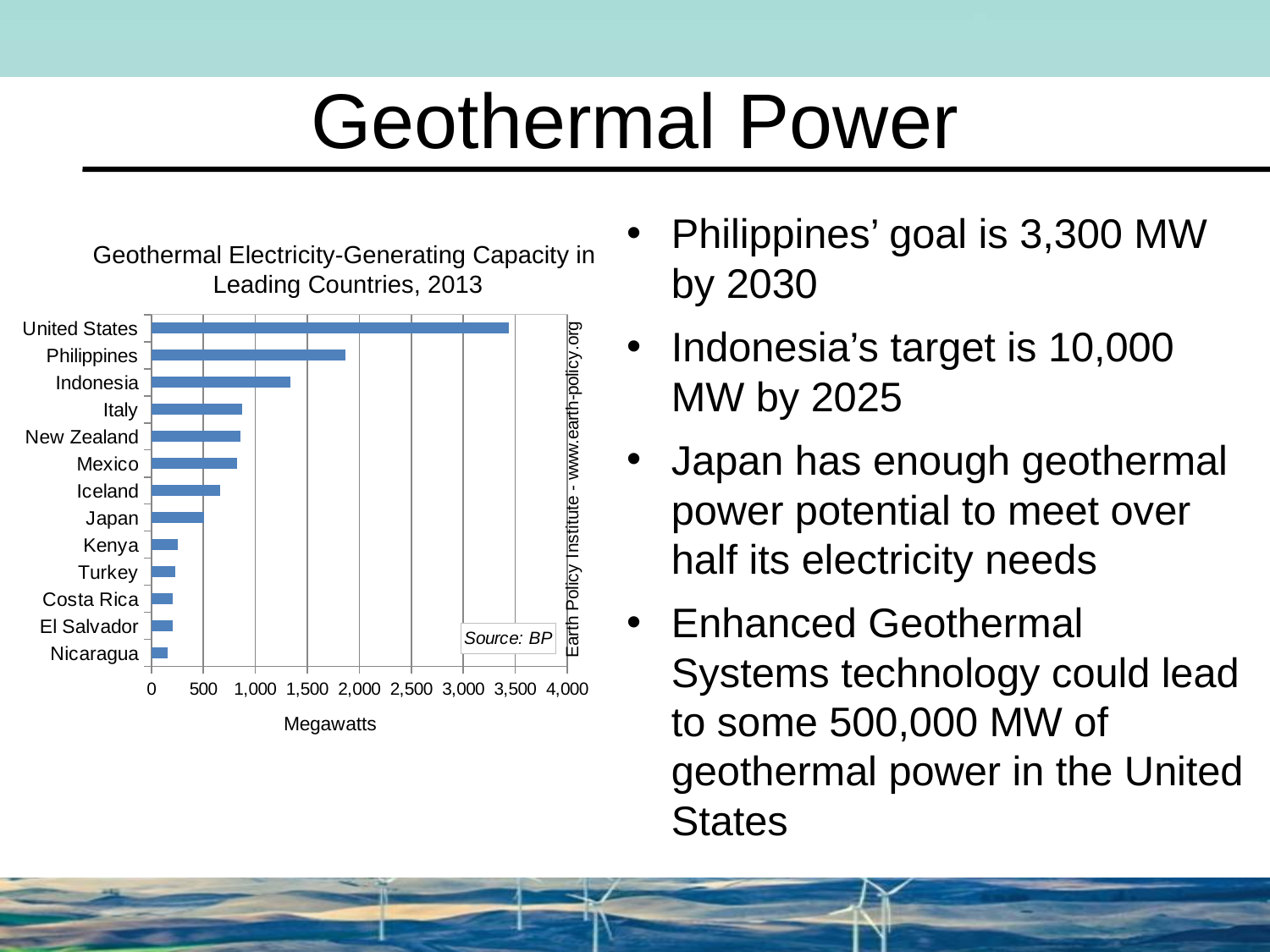
Is the value for Indonesia greater or less than 1,000? greater What is the label on the horizontal axis of the chart? Megawatts What kind of chart is shown on the slide? bar chart Is the value for Iceland greater or less than 500? greater Which country has the lowest geothermal electricity-generating capacity in the chart? Nicaragua Which has a larger geothermal capacity, Indonesia or Mexico? Indonesia Is the value for the Philippines greater or less than 1,500? greater What is the title of the chart? Geothermal Electricity-Generating Capacity in Leading Countries, 2013 Which country has the highest geothermal electricity-generating capacity in the chart? United States How many countries are shown in the chart? 13